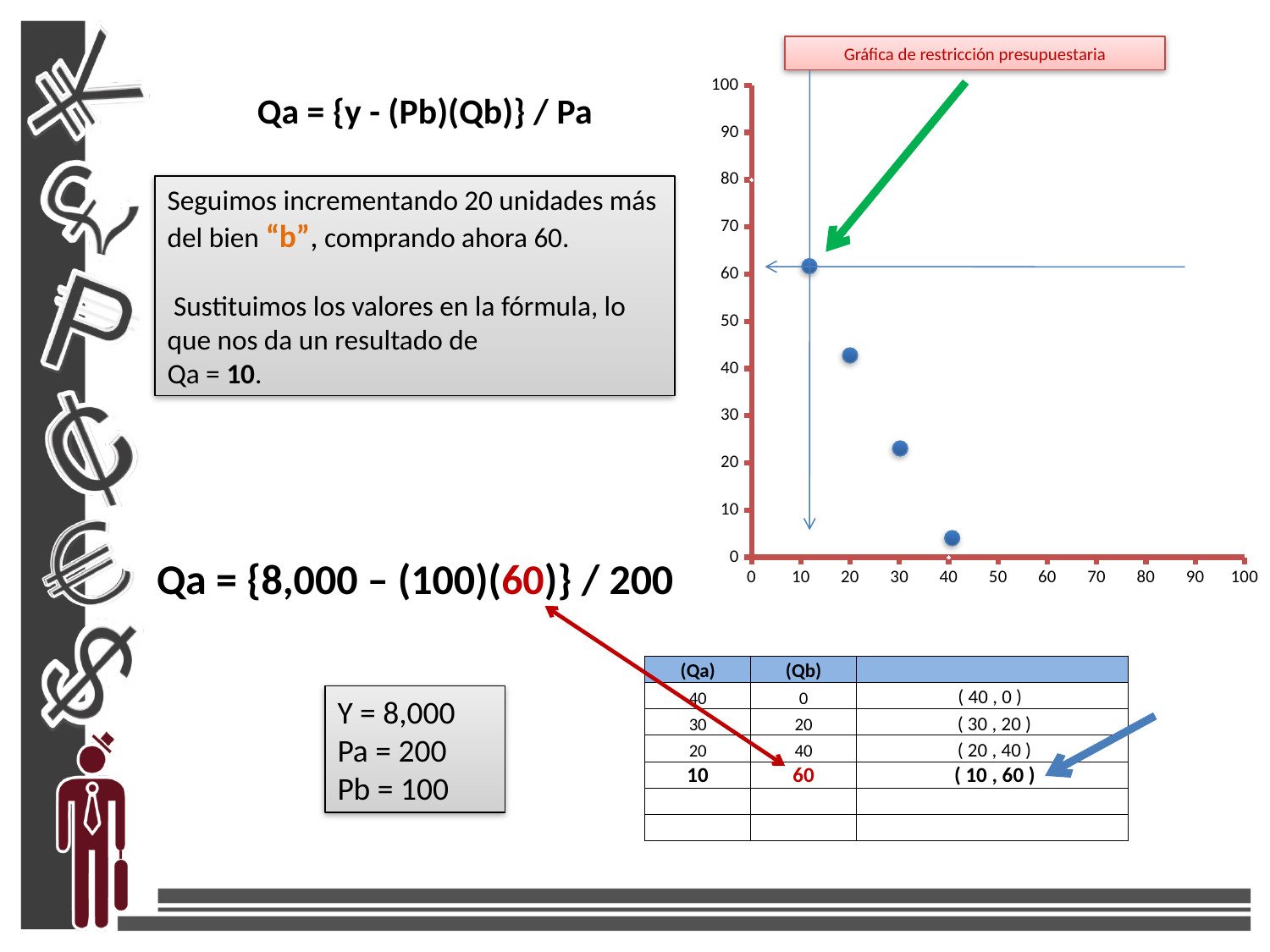
Is the y value of the point at x = 20 greater or less than 30? greater What is the title shown in the red box above the chart? Gráfica de restricción presupuestaria Do the plotted points rise or fall as the x value increases? fall Is the y value of the point at x = 30 greater or less than 30? less According to the table, what is the Qb value paired with Qa = 40? 0 Is the y value of the point at x = 10 greater or less than 50? greater Which plotted point has the highest y value, the one at x = 10 or the one at x = 40? the one at x = 10 What is the maximum value shown on the x axis of the chart? 100 According to the table, what is the Qb value paired with Qa = 10? 60 What kind of chart is shown on the slide? scatter chart